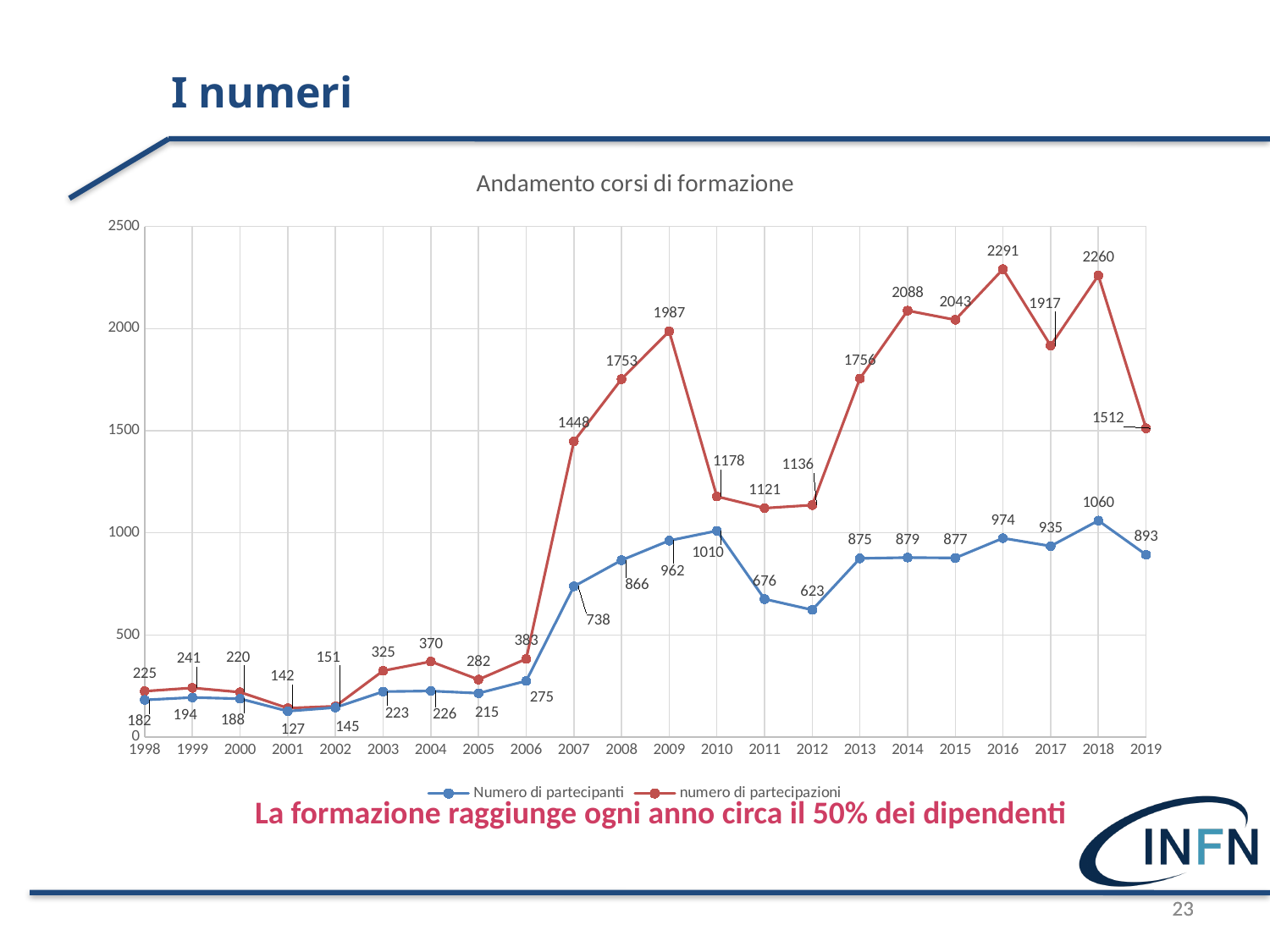
What is the value of 'numero di partecipazioni' in 2016? 2291 Does 'numero di partecipazioni' rise or fall from 2018 to 2019? fall Which is larger in 2009: 'numero di partecipazioni' or 'Numero di partecipanti'? numero di partecipazioni How many series does the legend list? 2 What is the value of 'Numero di partecipanti' in 2010? 1010 How many years are plotted along the x axis? 22 What type of chart is shown on the slide? line chart What is the title of the chart? Andamento corsi di formazione What is the difference between 'numero di partecipazioni' and 'Numero di partecipanti' in 2019? 619 In which year is 'Numero di partecipanti' lowest? 2001 In which year is 'numero di partecipazioni' highest? 2016 Is the value of 'numero di partecipazioni' in 2018 greater or less than 2000? greater